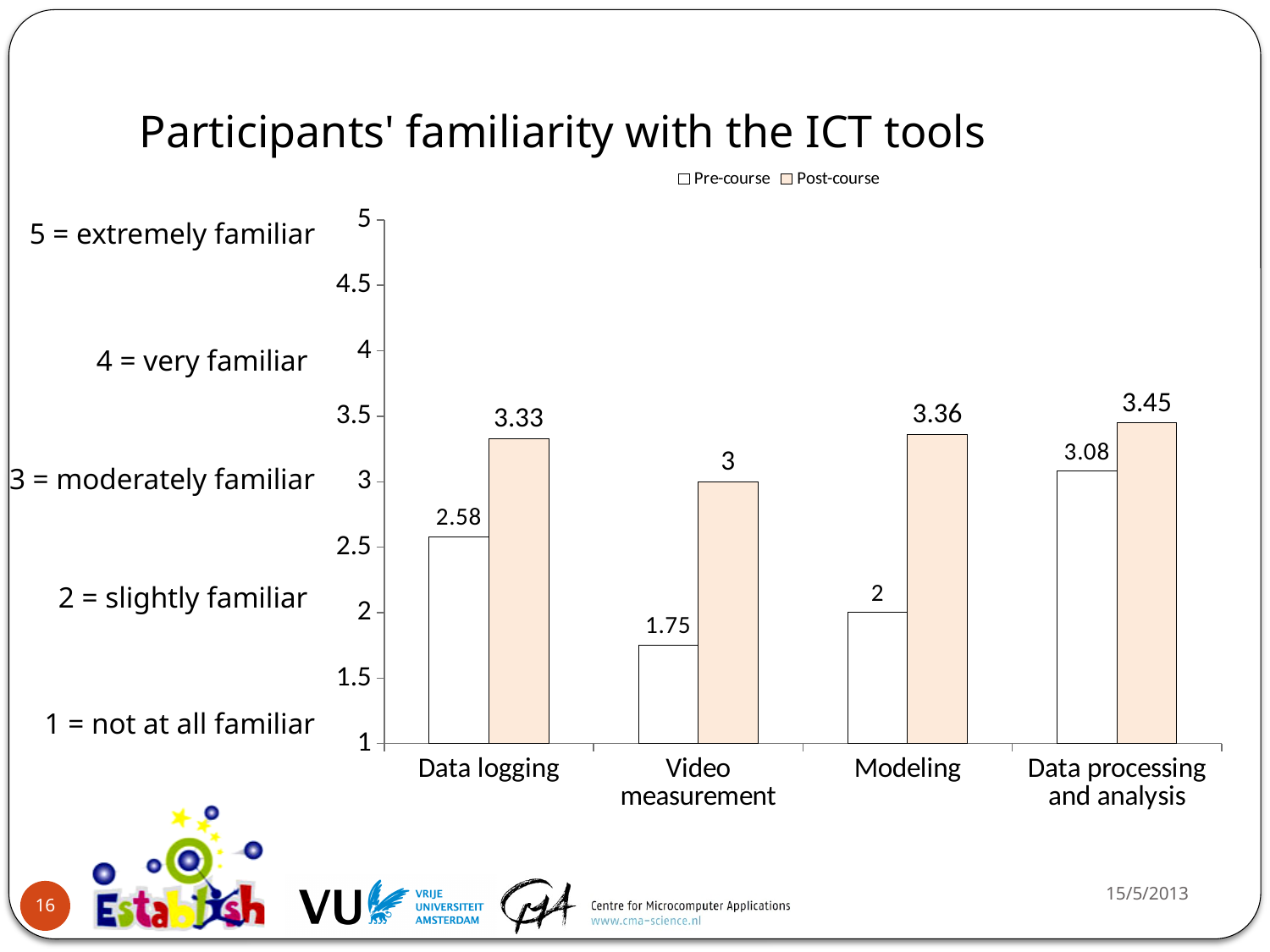
How many series does the legend list? 2 What is the Pre-course value for Data logging? 2.58 What kind of chart is shown on the slide? Bar chart What is the Pre-course value for Video measurement? 1.75 What is the title of the chart? Participants' familiarity with the ICT tools Which category has the highest Post-course value? Data processing and analysis How many categories are shown on the x axis? 4 Which is larger, the Pre-course value for Data logging or the Pre-course value for Modeling? Data logging Which category has the lowest Pre-course value? Video measurement What is the Post-course value for Data processing and analysis? 3.45 What is the Post-course value for Modeling? 3.36 What is the difference between the Post-course and Pre-course values for Modeling? 1.36